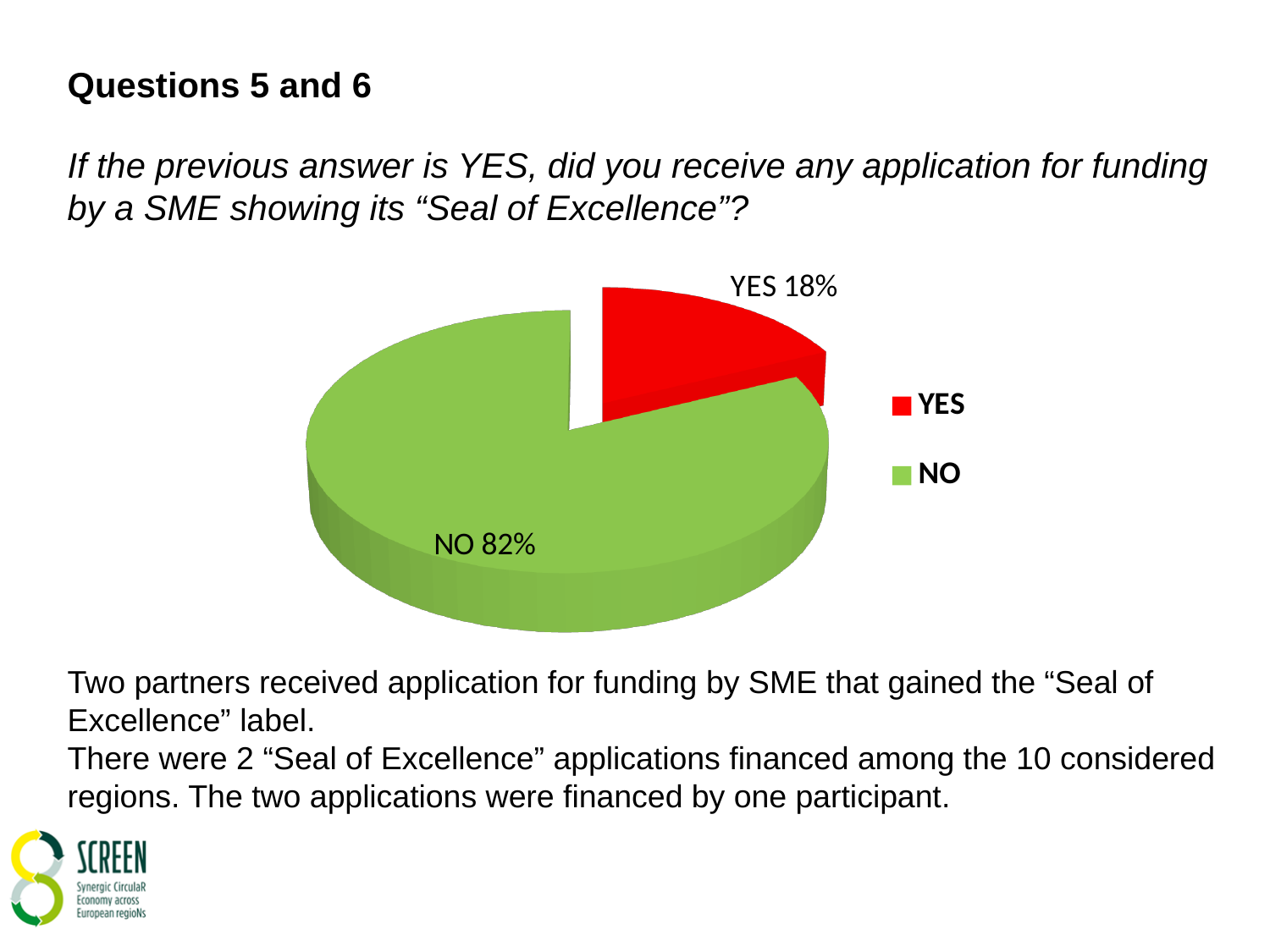
What colour is the YES slice in the pie chart? red What percentage of the pie is labelled NO? 82% What percentage of the pie is labelled YES? 18% What share of the pie does the YES slice represent? 18% Which slice of the pie is the smallest? YES What kind of chart is shown on the slide? pie chart How many slices does the pie chart have? 2 What is the difference in percentage points between the NO slice and the YES slice? 64 Which slice of the pie is the largest? NO Which slice is larger, YES or NO? NO What colour is the NO slice in the pie chart? green How many entries does the legend list? 2